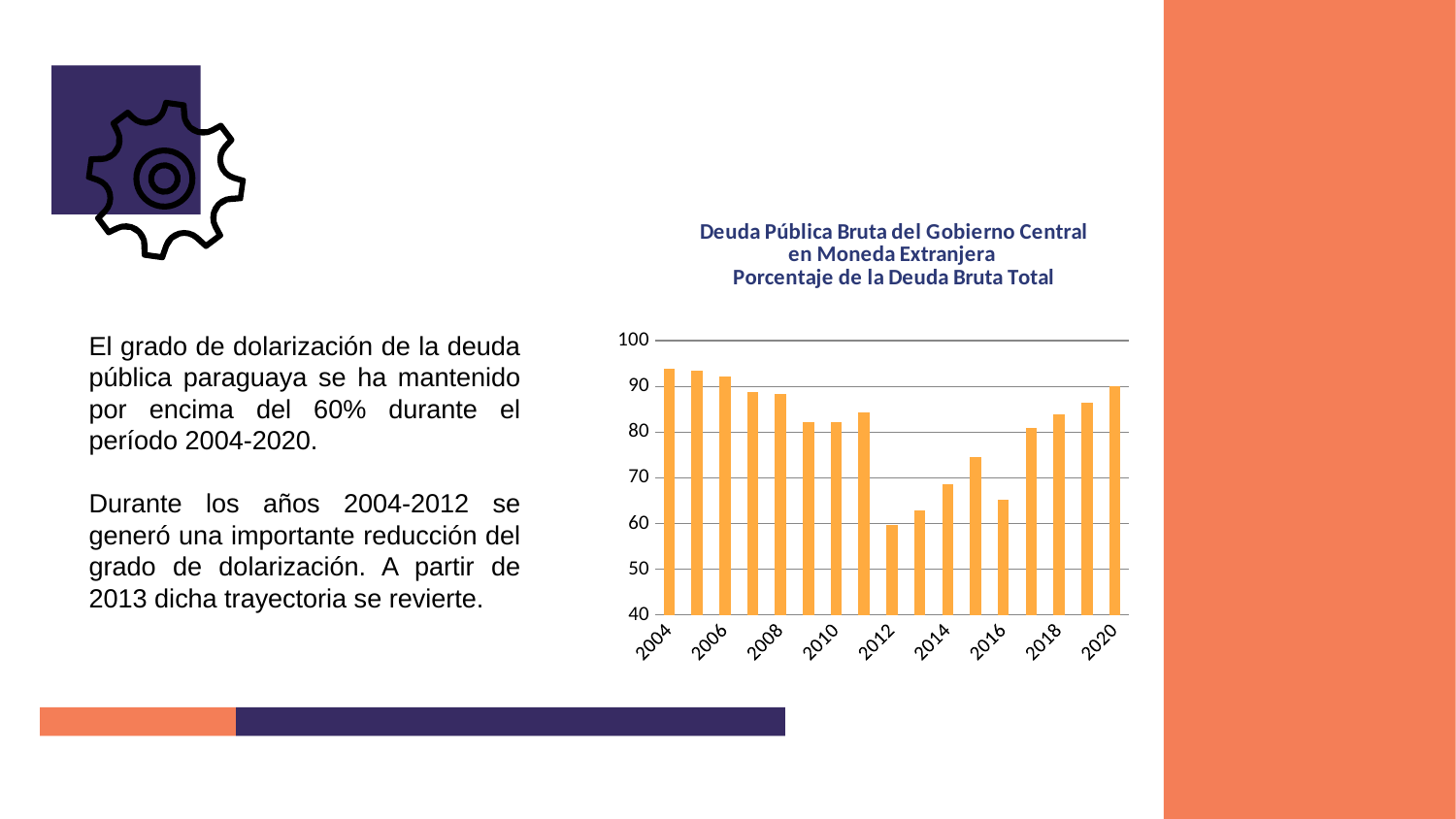
Is the value for 2012 greater or less than 70? less Which is larger, the value for 2016 or the value for 2020? 2020 What is the title of the chart? Deuda Pública Bruta del Gobierno Central en Moneda Extranjera Porcentaje de la Deuda Bruta Total Is the value for 2015 greater or less than 70? greater Which year has the lowest value in the chart? 2012 Is the value for 2004 greater or less than 90? greater What kind of chart is shown on the slide? bar chart How many bars (years) are plotted in the chart? 17 Which is larger, the value for 2004 or the value for 2012? 2004 Between 2004 and 2012, do the values generally rise or fall? fall